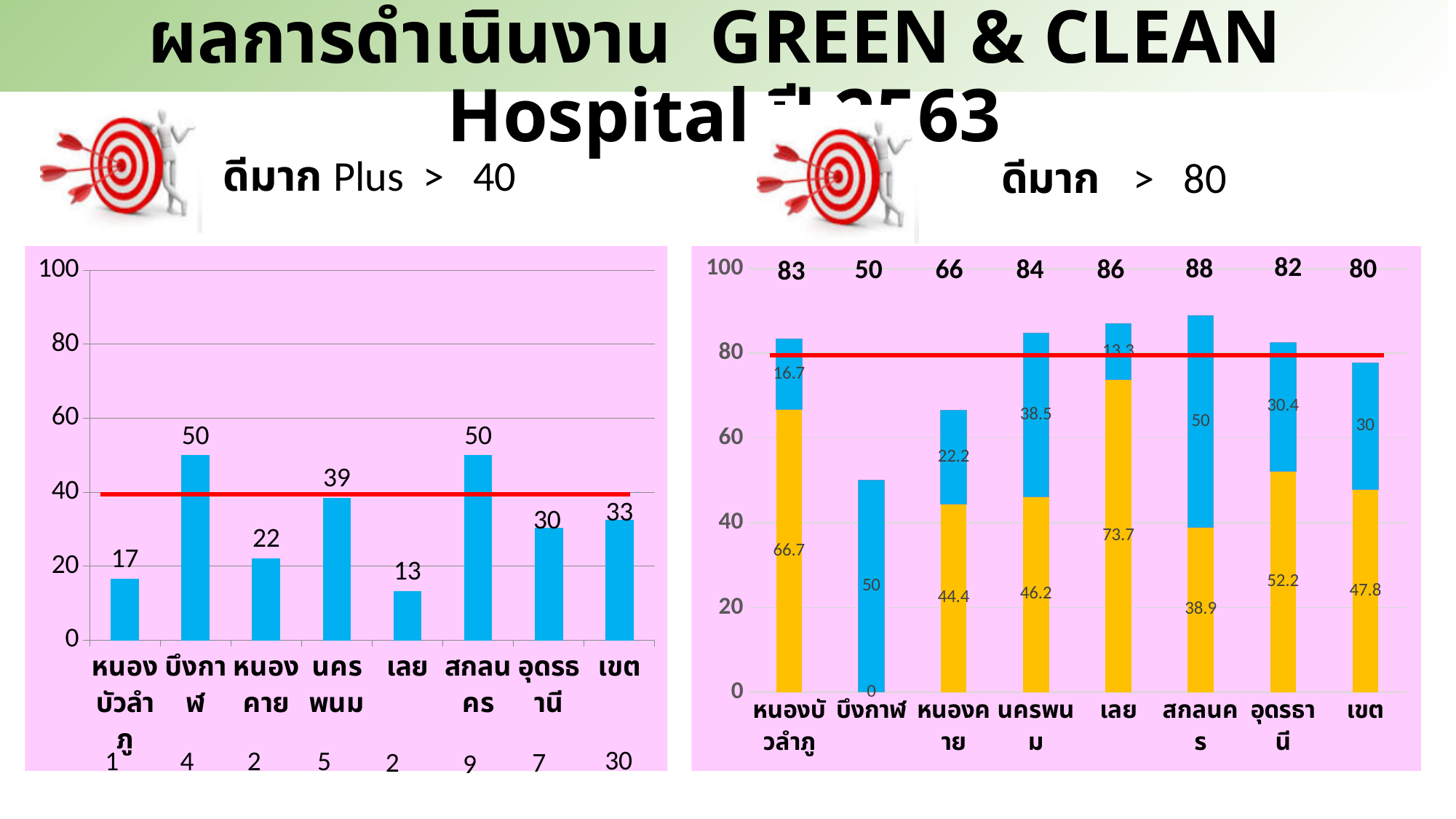
On the left chart, how many bars are plotted? 8 On the left chart, which is larger, the value for เขต or the value for หนองบัวลำภู? เขต On the right chart, which category has the lowest total? บึงกาฬ On the left chart, what is the difference between the values for อุดรธานี and หนองคาย? 8 On the left chart, what is the value for บึงกาฬ? 50 On the right chart, what is the value of the orange segment for เลย? 73.7 On the right chart, is the total for หนองคาย greater or less than 80? less What kind of chart is the left chart? bar chart On the left chart, which category has the lowest value? เลย On the right chart, what is the value of the blue segment for นครพนม? 38.5 On the left chart, what is the value for นครพนม? 39 On the right chart, what is the total printed above the bar for สกลนคร? 88